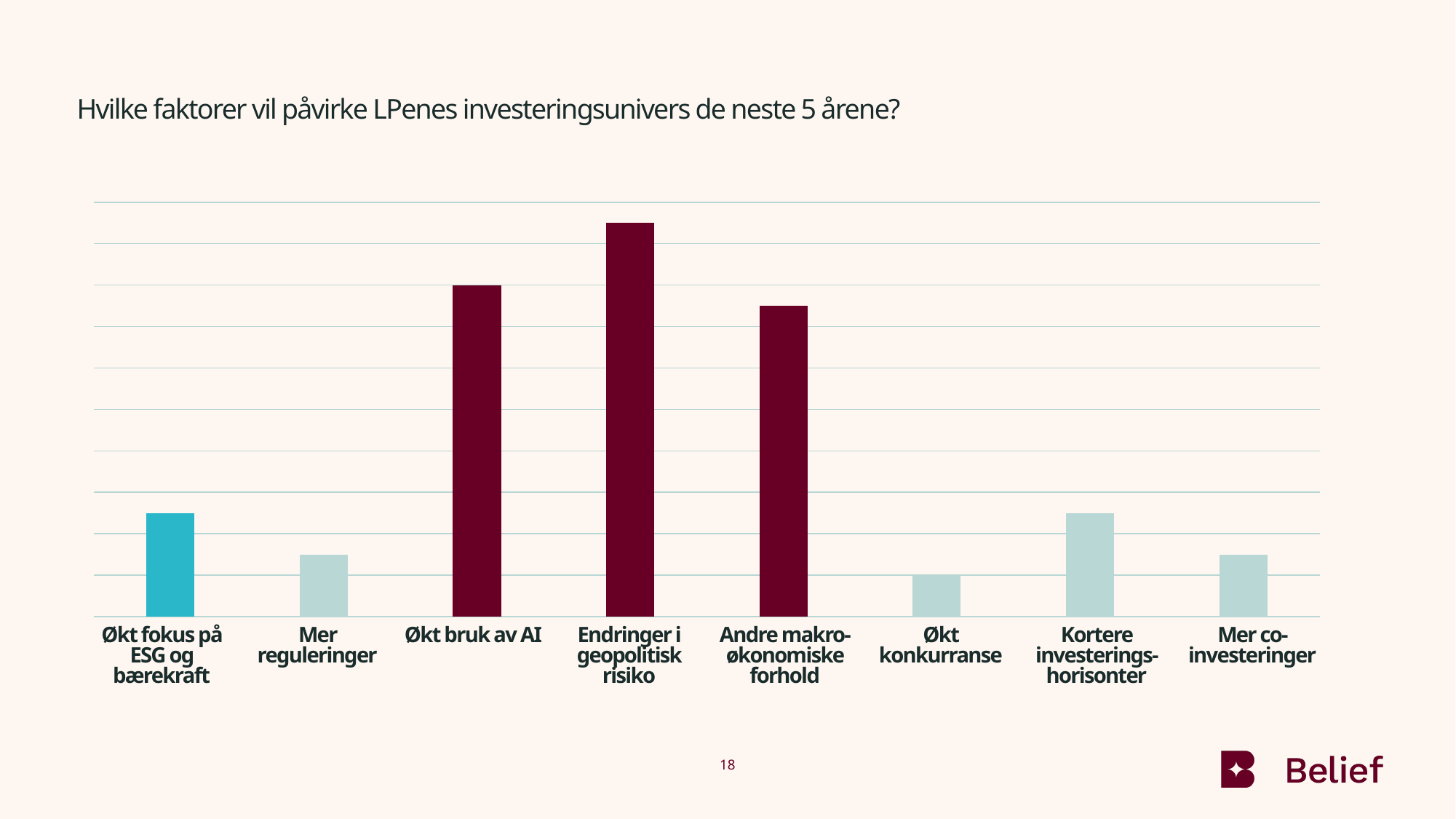
Which category has the second-highest bar? Økt bruk av AI Which category has the highest bar? Endringer i geopolitisk risiko Which is higher: the bar for 'Kortere investeringshorisonter' or the bar for 'Økt konkurranse'? Kortere investeringshorisonter What is the title of the chart on the slide? Hvilke faktorer vil påvirke LPenes investeringsunivers de neste 5 årene? Which is higher: the bar for 'Endringer i geopolitisk risiko' or the bar for 'Økt bruk av AI'? Endringer i geopolitisk risiko Which is higher: the bar for 'Økt fokus på ESG og bærekraft' or the bar for 'Mer reguleringer'? Økt fokus på ESG og bærekraft How many bars are coloured dark red (maroon)? 3 Which category has the lowest bar? Økt konkurranse What kind of chart is shown on the slide? Bar chart How many categories (bars) does the chart show? 8